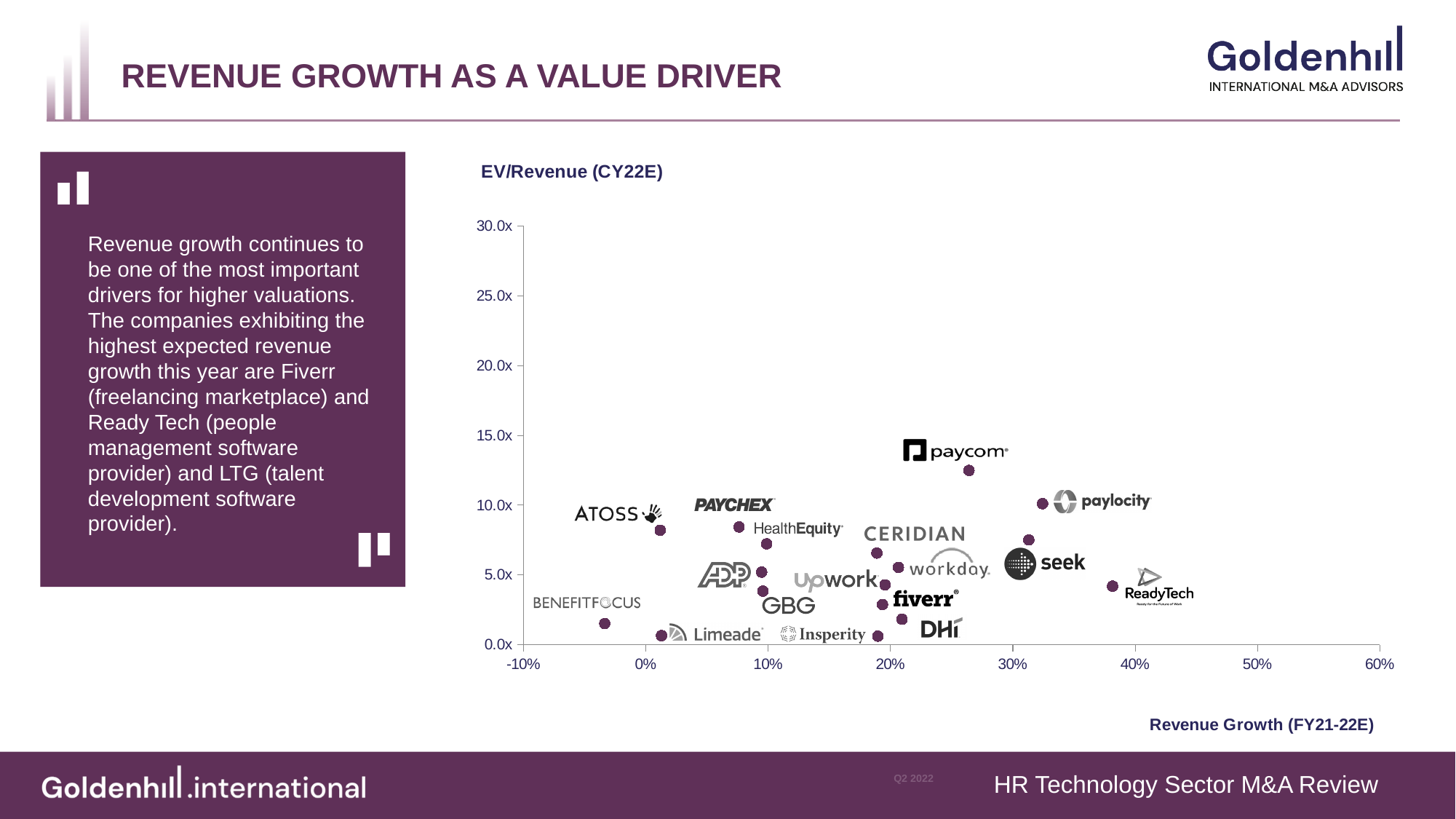
Is the EV/Revenue value for Atoss greater or less than 5.0x? greater Is the Revenue Growth value for Paylocity greater or less than 30%? greater Is the EV/Revenue value for Paycom greater or less than 10.0x? greater How many companies are plotted on the chart? 17 Which has the higher Revenue Growth, ReadyTech or Seek? ReadyTech Which has the higher EV/Revenue, Paycom or Paylocity? Paycom Which company has the highest Revenue Growth (FY21-22E) on the chart? ReadyTech What is the label of the vertical axis of the chart? EV/Revenue (CY22E) Which company has the highest EV/Revenue (CY22E) on the chart? Paycom What kind of chart is shown on the slide? Scatter chart Which company has the lowest Revenue Growth (FY21-22E) on the chart? Benefitfocus